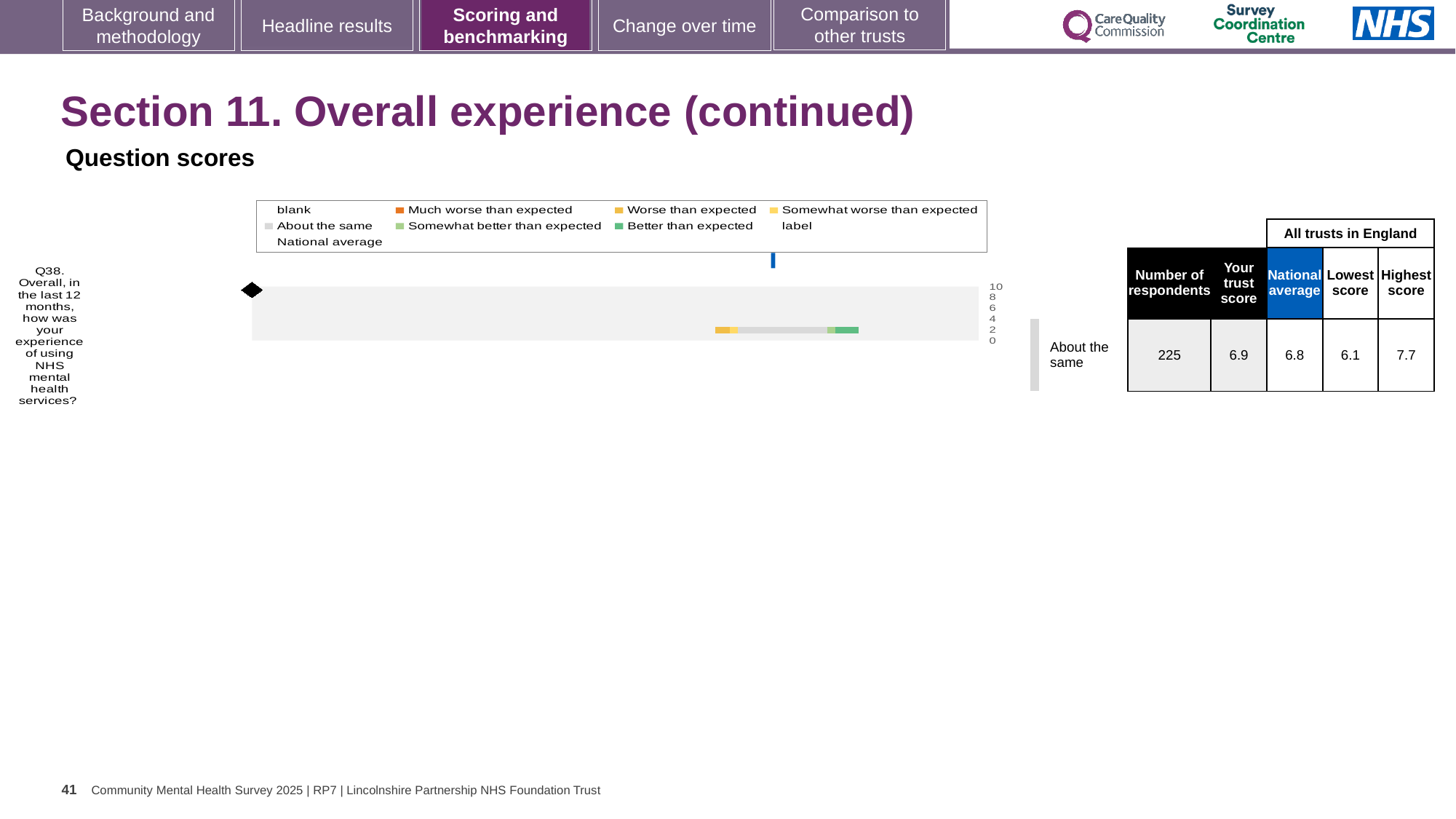
What benchmark category is shown for Q38 next to the chart? About the same What is the number of respondents for Q38 in the table? 225 What kind of chart is shown on the slide? bar chart Which question is plotted in the chart? Q38. Overall, in the last 12 months, how was your experience of using NHS mental health services? What is the trust's score for Q38 in the table? 6.9 What is the heading of the slide's chart section? Question scores What is the lowest score among all trusts in England for Q38? 6.1 Which is larger for Q38, the trust score or the national average? trust score How many survey questions are plotted in the chart? 1 What is the difference between the highest and lowest scores among all trusts in England for Q38? 1.6 What is the highest score among all trusts in England for Q38? 7.7 What is the national average for Q38 in the table? 6.8